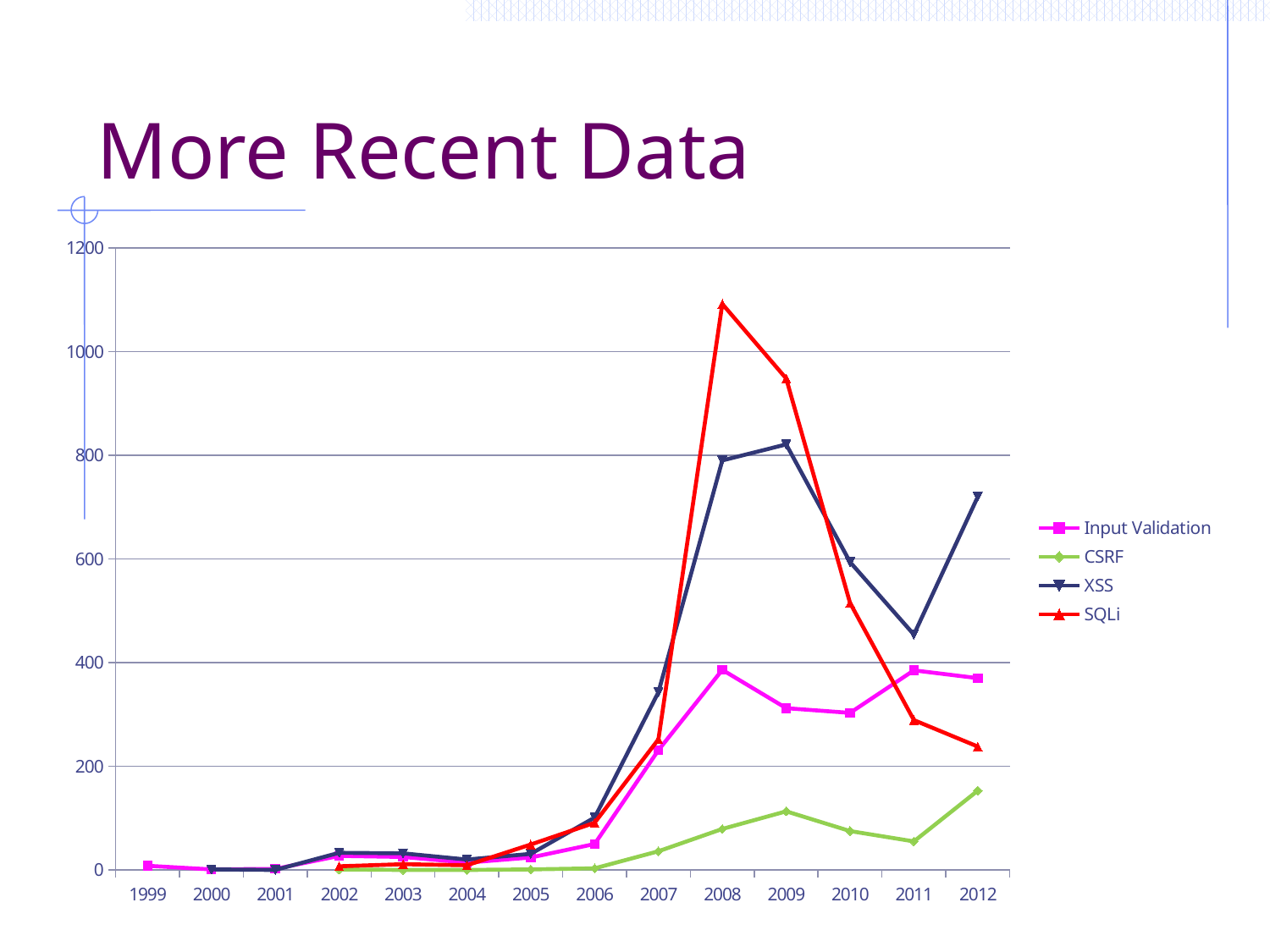
In which year does the XSS series reach its highest value? 2009 Is the value for XSS in 2012 greater or less than 600? greater Is the value for CSRF in 2012 greater or less than 200? less What kind of chart is shown on the slide? line chart In which year does the SQLi series reach its highest value? 2008 Is the value for SQLi in 2008 greater or less than 1000? greater How many series does the legend list? 4 Does the SQLi series rise or fall from 2008 to 2012? fall Which series has the lowest value in 2012? CSRF In 2012, which is larger: XSS or SQLi? XSS Which series reaches the highest value anywhere on the chart? SQLi How many years are shown along the x axis? 14